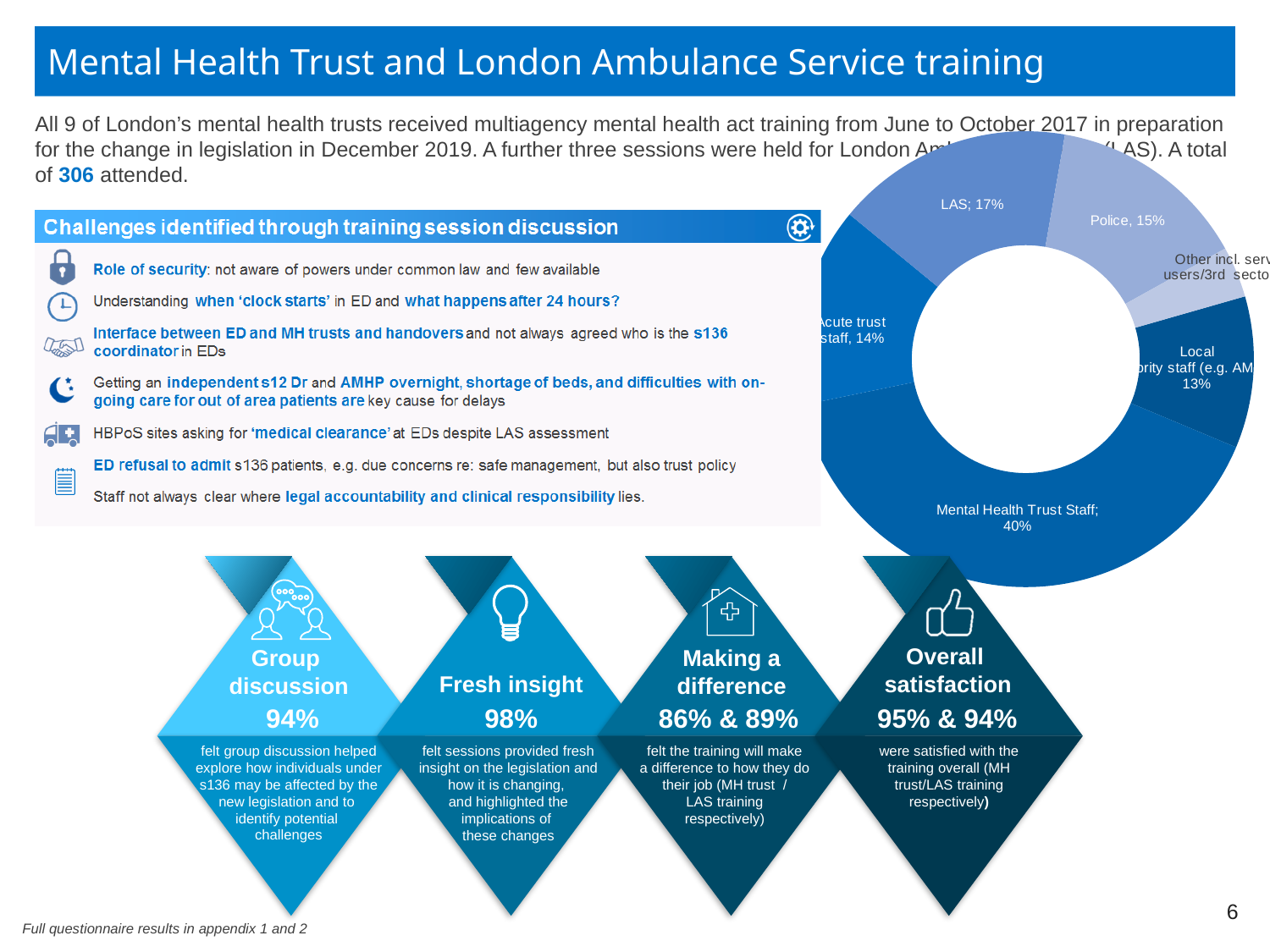
In the doughnut chart, which is larger: the LAS slice or the Police slice? LAS In the doughnut chart, what percentage is shown for Police? 15% How many slices does the doughnut chart have? 6 In the doughnut chart, what is the difference in percentage points between Police and Local security staff? 2 In the doughnut chart, is the Mental Health Trust Staff share greater or less than 30%? greater What kind of chart is shown on the right of the slide? doughnut chart In the doughnut chart, what percentage is shown for LAS? 17% In the doughnut chart, what percentage is shown for Local security staff? 13% Which category has the largest slice in the doughnut chart? Mental Health Trust Staff In the doughnut chart, what percentage is shown for Acute trust staff? 14% In the doughnut chart, what share of attendees were Mental Health Trust Staff? 40% In the doughnut chart, what is the difference in percentage points between Mental Health Trust Staff and LAS? 23